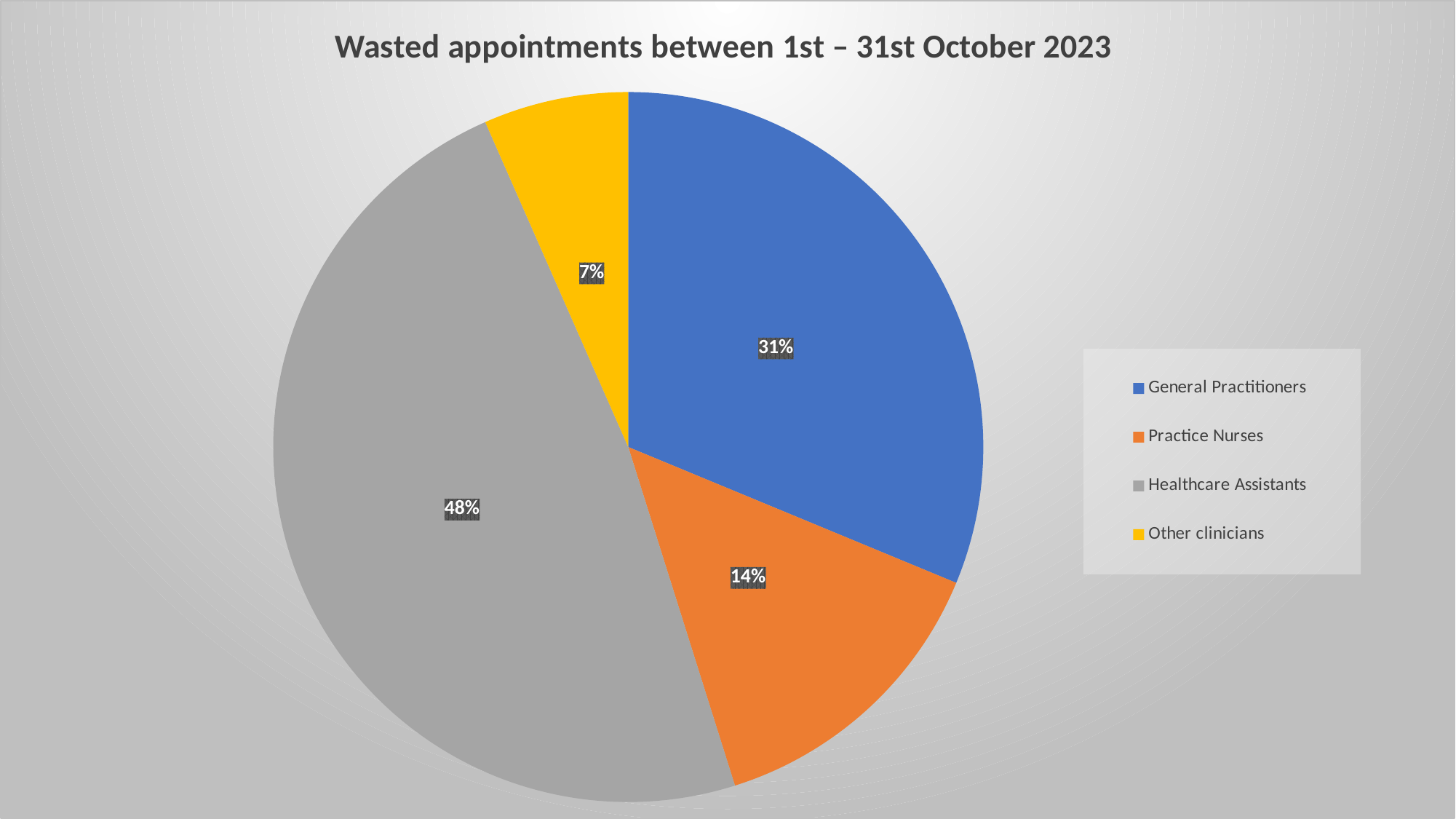
What share of wasted appointments is attributed to Healthcare Assistants? 48% What is the title of the chart? Wasted appointments between 1st – 31st October 2023 What share of wasted appointments is attributed to General Practitioners? 31% What share of wasted appointments is attributed to Other clinicians? 7% What is the difference in percentage points between Practice Nurses and Other clinicians? 7 What is the difference in percentage points between Healthcare Assistants and General Practitioners? 17 How many categories does the pie chart show? 4 Which category has the smallest slice of the pie? Other clinicians Which is larger, the share for General Practitioners or the share for Practice Nurses? General Practitioners What kind of chart is shown on the slide? Pie chart Which category has the largest slice of the pie? Healthcare Assistants